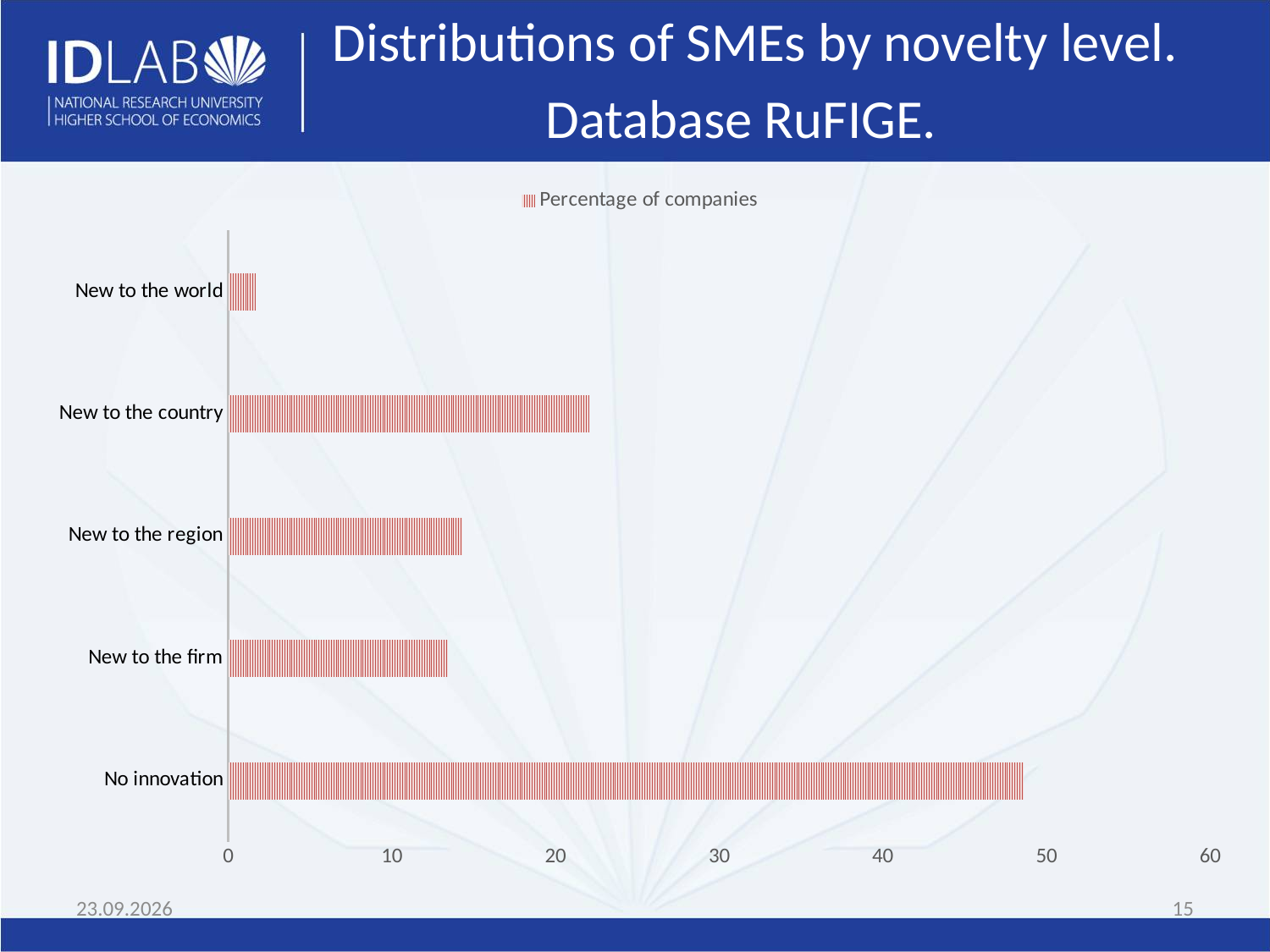
What kind of chart is shown on the slide? bar chart What is the name of the series shown in the legend? Percentage of companies How many series does the legend list? 1 Which category has the highest percentage of companies? No innovation Is the value for New to the country greater or less than 20? greater Is the value for New to the region greater or less than 20? less Which is larger, the value for New to the country or the value for New to the firm? New to the country Which category has the lowest percentage of companies? New to the world Is the value for New to the world greater or less than 10? less What is the title of the slide containing the chart? Distributions of SMEs by novelty level. Database RuFIGE. How many categories are shown on the chart? 5